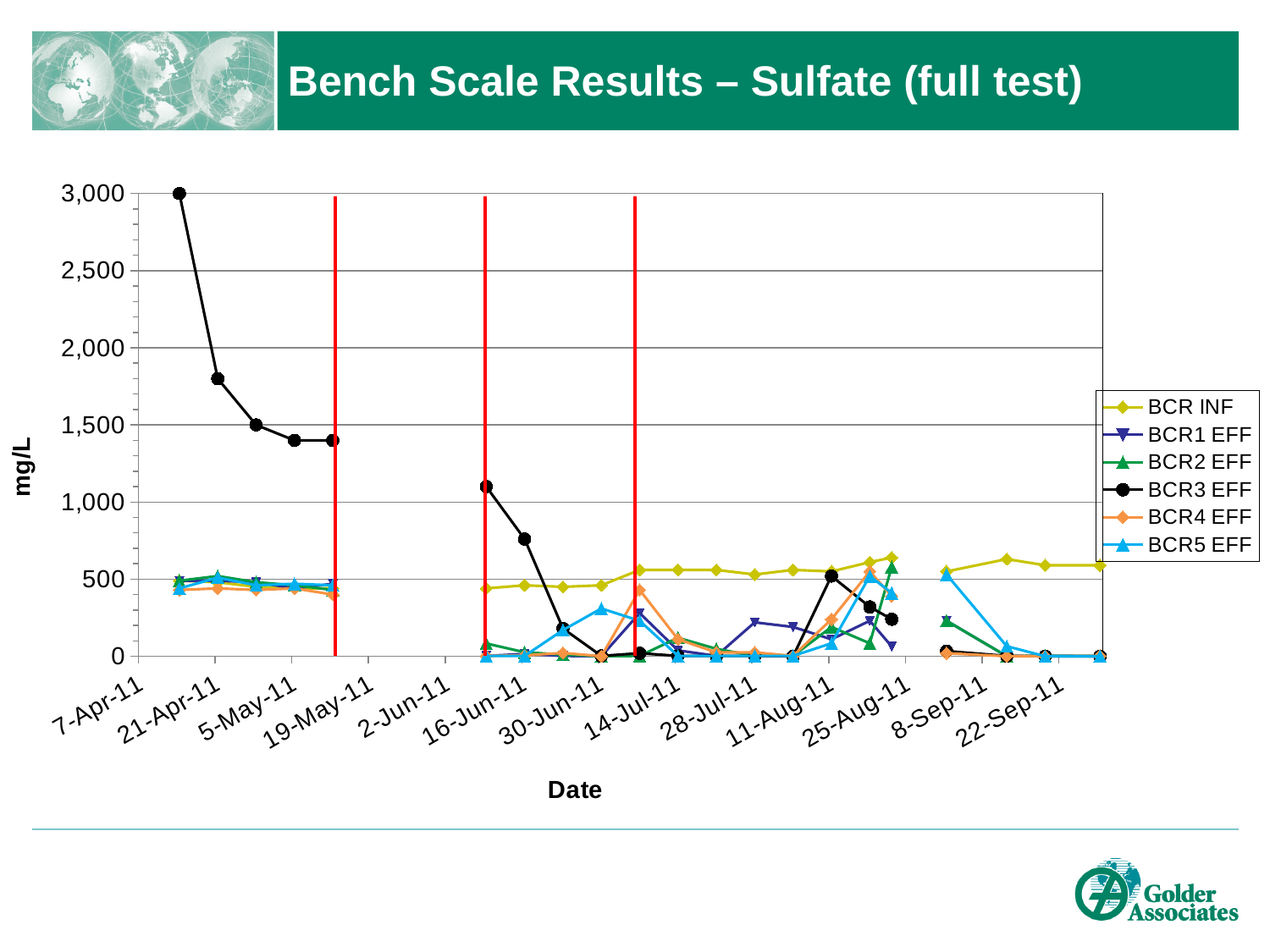
Is the value for BCR3 EFF at 21-Apr-11 greater or less than 2,000? less What is the title of the x axis? Date What is the label on the y axis? mg/L Is the value for BCR3 EFF at 16-Jun-11 greater or less than 1,000? less How many series does the legend list? 6 Does the BCR3 EFF series rise or fall between 7-Apr-11 and 19-May-11? fall Which series reaches the highest value on the chart? BCR3 EFF What kind of chart is shown on the slide? line chart Is the value for BCR3 EFF at 21-Apr-11 greater or less than 1,500? greater